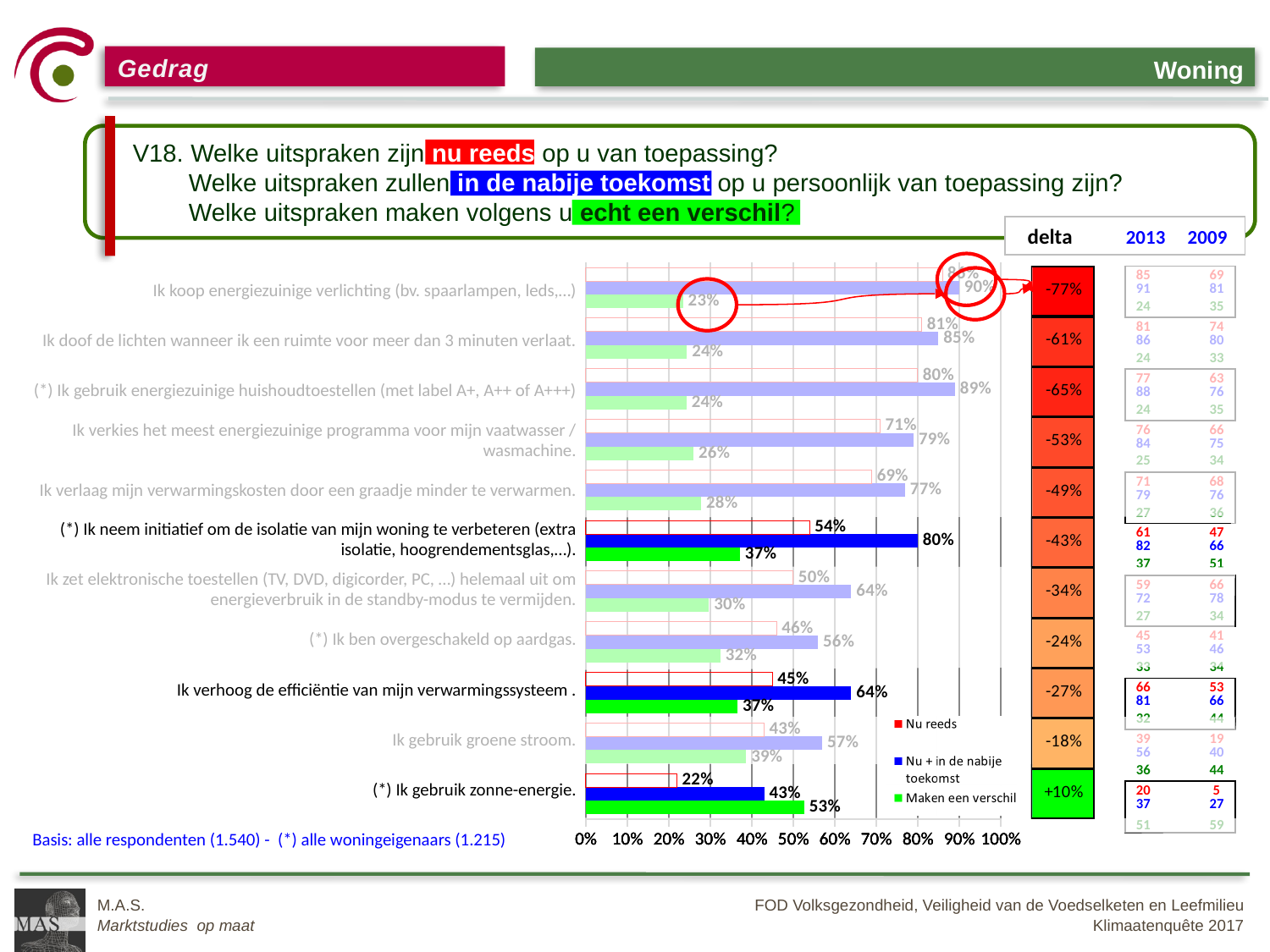
What is the 'Nu + in de nabije toekomst' value for '(*) Ik neem initiatief om de isolatie van mijn woning te verbeteren'? 80% For 'Ik gebruik groene stroom.', which is larger: the 'Nu reeds' value or the 'Maken een verschil' value? Nu reeds For '(*) Ik neem initiatief om de isolatie van mijn woning te verbeteren', what is the difference between the 'Nu + in de nabije toekomst' value and the 'Nu reeds' value? 26 percentage points How many statements (categories) are plotted in the chart? 11 What is the 'Nu reeds' value for 'Ik verhoog de efficiëntie van mijn verwarmingssysteem'? 45% What is the 'Maken een verschil' value for '(*) Ik gebruik zonne-energie.'? 53% Which statement has the highest 'Nu + in de nabije toekomst' value? Ik koop energiezuinige verlichting (bv. spaarlampen, leds,...) Which statement has the lowest 'Nu reeds' value? (*) Ik gebruik zonne-energie. Which statement has the highest 'Maken een verschil' value? (*) Ik gebruik zonne-energie. How many series does the chart legend list? 3 What are the three series names listed in the chart legend? Nu reeds; Nu + in de nabije toekomst; Maken een verschil What kind of chart is shown on the slide? bar chart